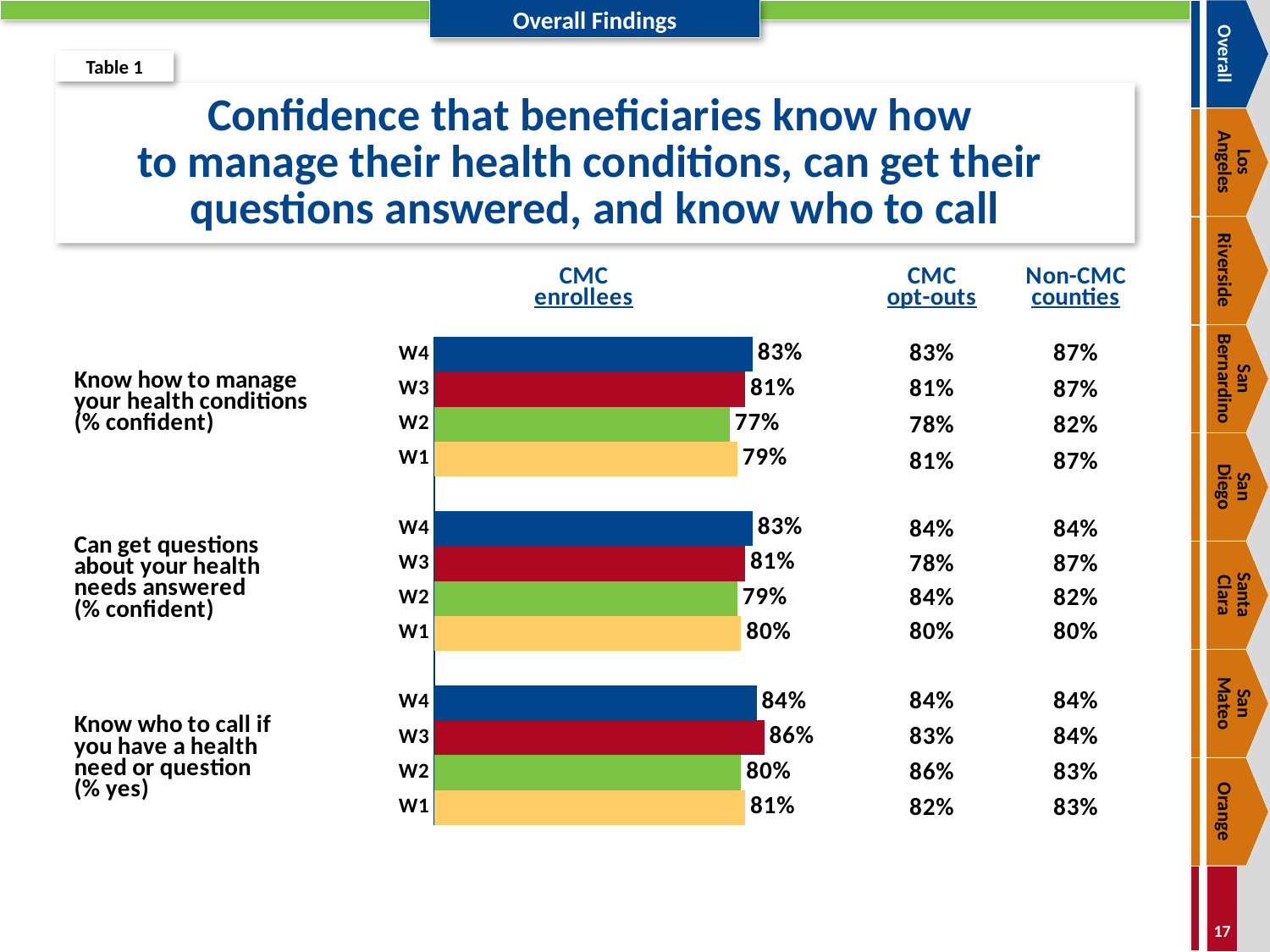
What colour are the W4 bars in the CMC enrollees chart? Blue For "Know how to manage your health conditions", do the CMC enrollees values rise or fall from W2 to W4? Rise What is the W1 value for "Know how to manage your health conditions" in the Non-CMC counties column? 87% For "Know who to call if you have a health need or question", which wave has the highest CMC enrollees value? W3 In the CMC enrollees bar chart, what is the W2 value for "Can get questions about your health needs answered"? 79% In the CMC enrollees bar chart, what is the W3 value for "Know who to call if you have a health need or question"? 86% For "Know how to manage your health conditions", which wave has the lowest CMC enrollees value? W2 For "Can get questions about your health needs answered", which CMC enrollees value is larger, W3 or W1? W3 In the CMC enrollees bar chart, what is the W4 value for "Know how to manage your health conditions"? 83% What kind of chart is used to show the CMC enrollees values? Bar chart How many bars are shown for each of the three survey items in the CMC enrollees chart? 4 For "Know how to manage your health conditions", what is the difference between the W4 and W2 CMC enrollees values? 6 percentage points